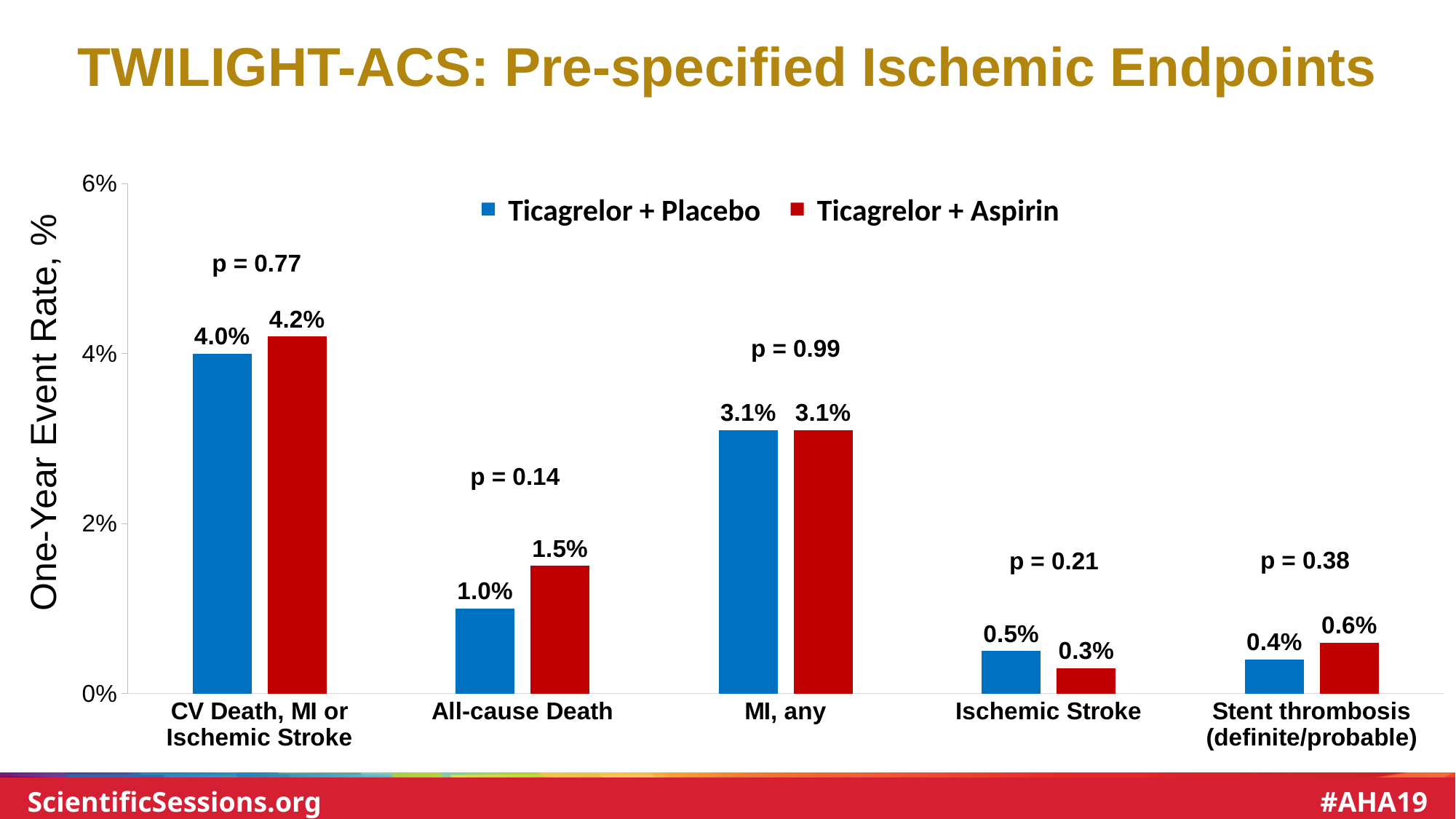
What is the one-year event rate for Ticagrelor + Placebo for All-cause Death? 1.0% What kind of chart is shown on the slide? Bar chart How many series does the legend list? 2 What is the difference between the Ticagrelor + Aspirin and Ticagrelor + Placebo event rates for All-cause Death? 0.5% How many endpoint categories are shown on the x axis? 5 Is the Ticagrelor + Placebo event rate for MI, any greater or less than 2%? greater Which endpoint has the lowest event rate for Ticagrelor + Aspirin? Ischemic Stroke Which endpoint has the highest event rate for Ticagrelor + Placebo? CV Death, MI or Ischemic Stroke For Stent thrombosis (definite/probable), which group has the higher event rate, Ticagrelor + Placebo or Ticagrelor + Aspirin? Ticagrelor + Aspirin What is the one-year event rate for Ticagrelor + Aspirin for CV Death, MI or Ischemic Stroke? 4.2% What p-value is shown for the MI, any endpoint? p = 0.99 What is the one-year event rate for Ticagrelor + Aspirin for Ischemic Stroke? 0.3%